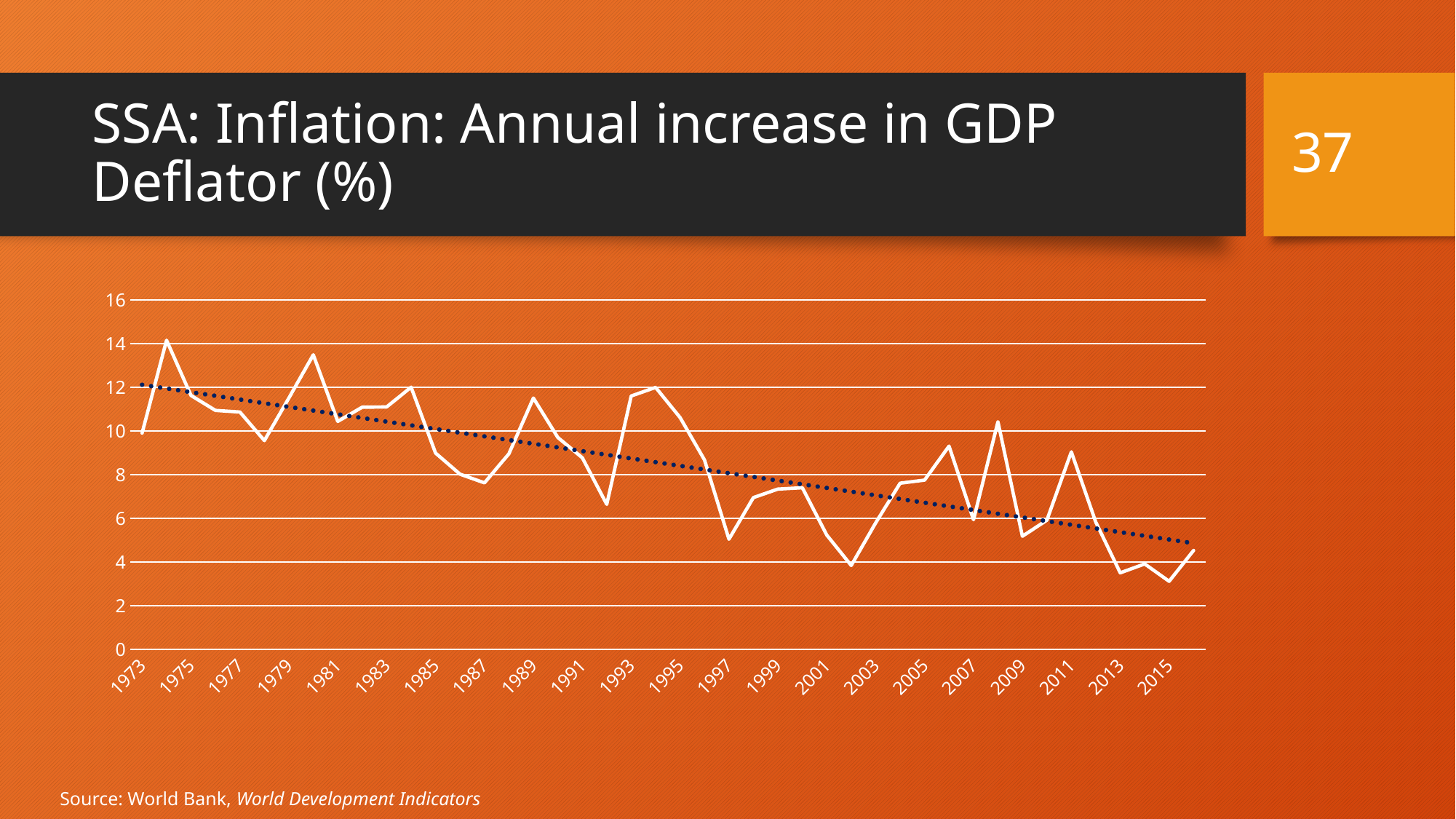
What kind of chart is shown on the slide? line chart Is the value for 2002 greater or less than 6? less What is the source cited for the chart data? World Bank, World Development Indicators What is the highest value shown on the vertical axis? 16 Overall, do the values of the annual increase in GDP deflator rise or fall from 1973 to 2016? fall Which is larger, the value for 1980 or the value for 2002? 1980 Is the value for 1992 greater or less than 8? less Which year has the highest value on the chart? 1974 Is the value for 2008 greater or less than 8? greater